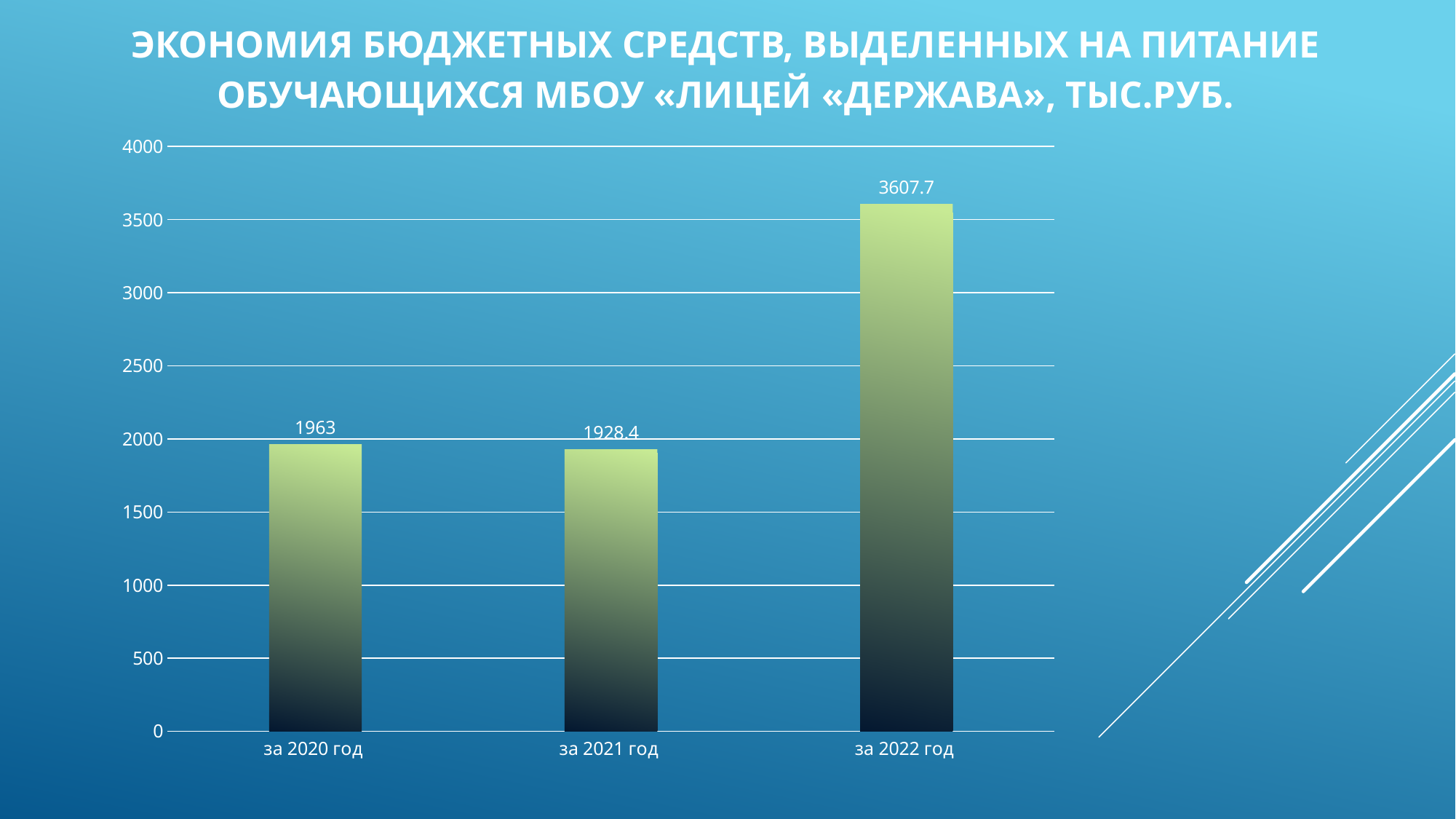
Which is larger, the value for за 2022 год or за 2021 год? за 2022 год Which year has the lowest value? за 2021 год What is the difference between the values for за 2020 год and за 2021 год? 34.6 What is the value for за 2021 год? 1928.4 What kind of chart is shown on the slide? bar chart How many categories are shown on the x axis? 3 Which year has the highest value? за 2022 год What is the value for за 2022 год? 3607.7 What is the highest value shown on the vertical axis? 4000 What is the value for за 2020 год? 1963 Is the value for за 2022 год greater or less than 3500? greater What is the difference between the values for за 2022 год and за 2020 год? 1644.7